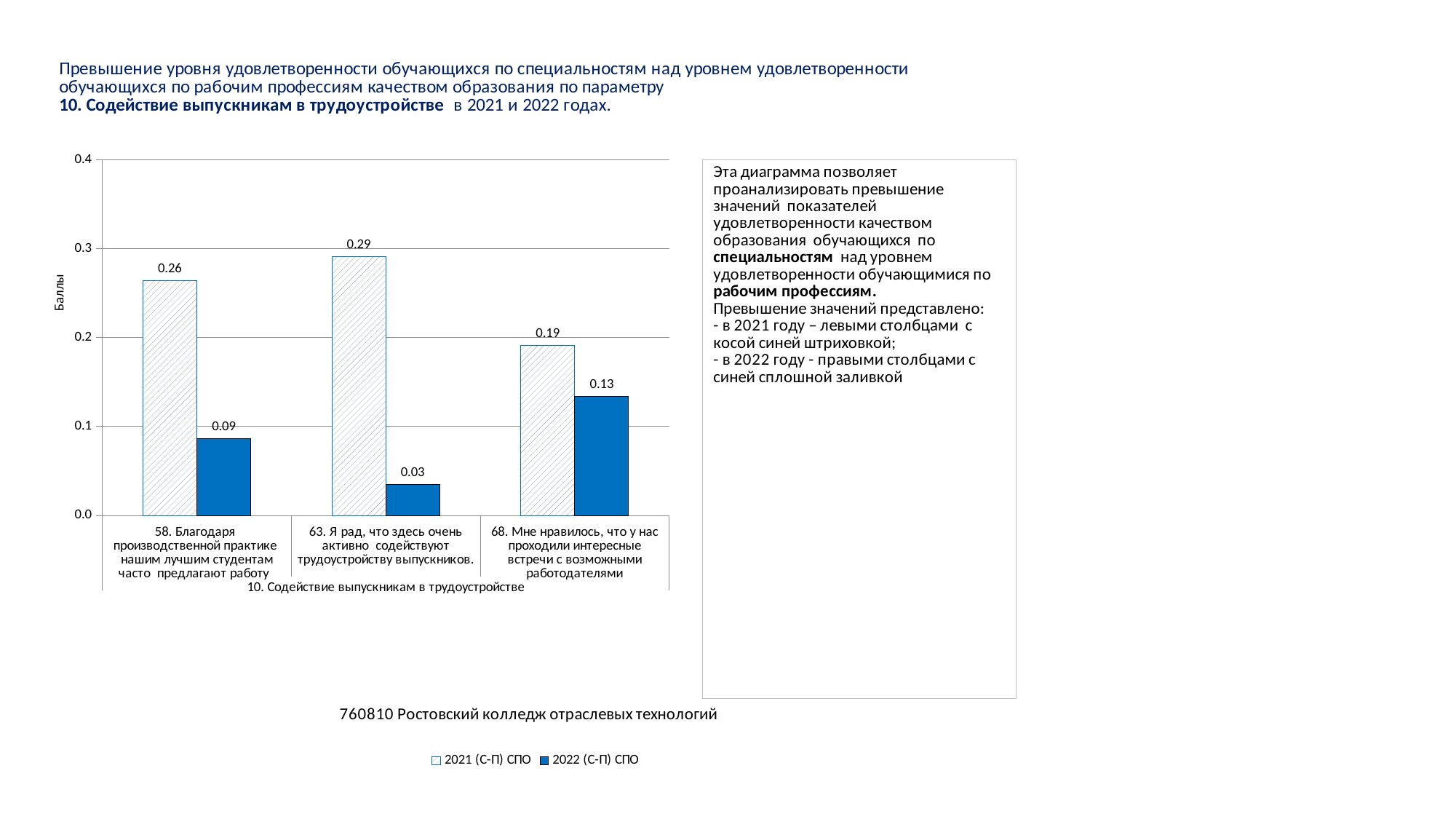
What is the difference between the 2021 and 2022 values for category 63? 0.26 What is the difference between the 2021 and 2022 values for category 58? 0.17 What is the value for 2022 (С-П) СПО for category 68 (Мне нравилось, что у нас проходили интересные встречи с возможными работодателями)? 0.13 What is the value for 2022 (С-П) СПО for category 63 (Я рад, что здесь очень активно содействуют трудоустройству выпускников)? 0.03 What kind of chart is shown on the slide? bar chart How many series does the legend list? 2 How many categories are shown on the x axis? 3 Which category has the highest value for 2021 (С-П) СПО? 63. Я рад, что здесь очень активно содействуют трудоустройству выпускников. Which category has the lowest value for 2022 (С-П) СПО? 63. Я рад, что здесь очень активно содействуют трудоустройству выпускников. Which is larger: the 2022 value for category 58 or the 2022 value for category 68? 2022 value for category 68 Is the 2021 value for category 68 greater or less than 0.2? less What is the value for 2021 (С-П) СПО for category 58 (Благодаря производственной практике нашим лучшим студентам часто предлагают работу)? 0.26